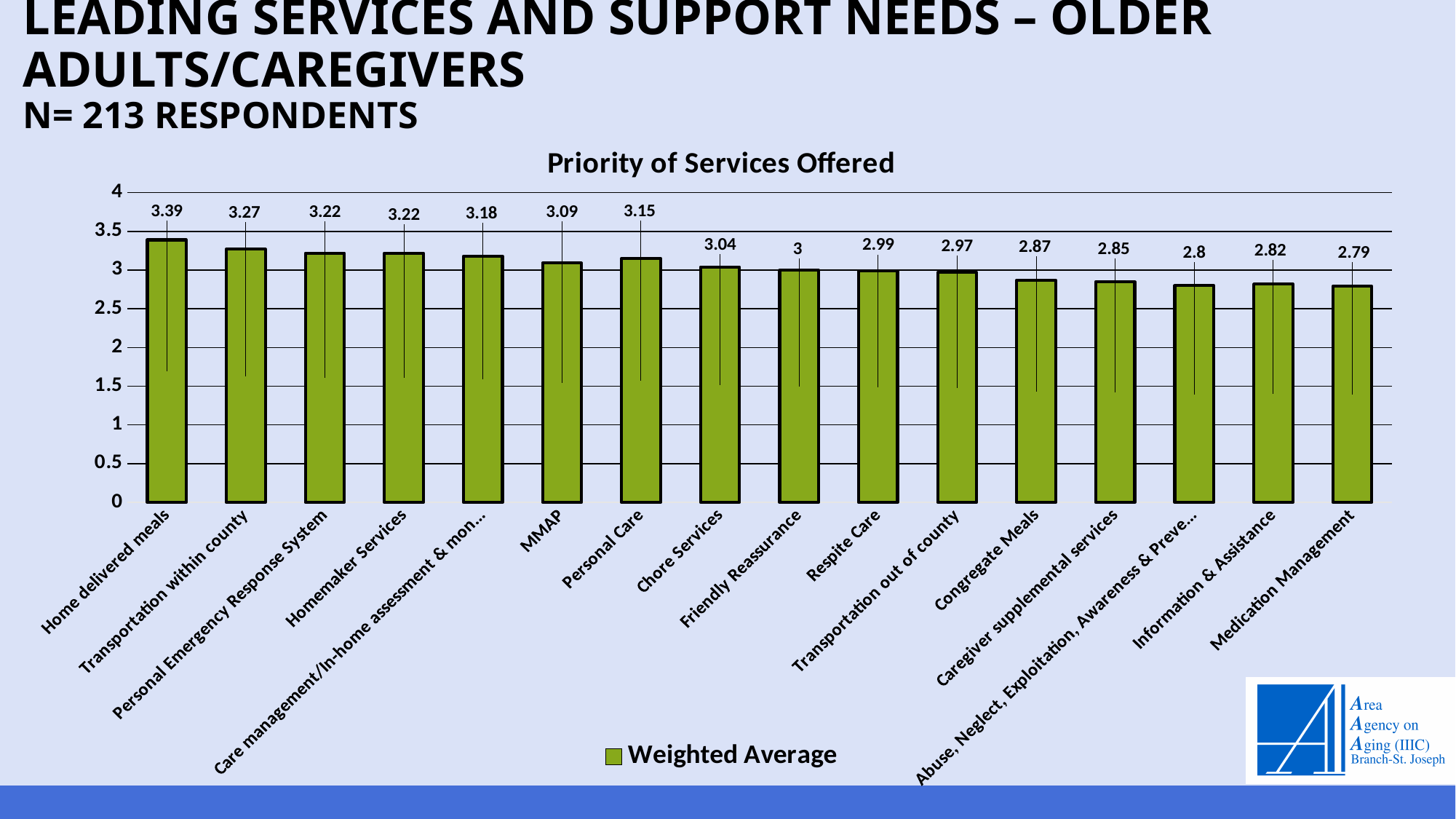
What is the weighted average for MMAP? 3.09 How many services are shown in the chart? 16 How many series does the legend list? 1 What is the weighted average for Medication Management? 2.79 What is the difference between the weighted averages for Home delivered meals and Transportation within county? 0.12 What type of chart is shown on the slide? Bar chart What is the weighted average for Chore Services? 3.04 What is the title of the chart? Priority of Services Offered Which service has the lowest weighted average? Medication Management Which service has the highest weighted average? Home delivered meals What is the weighted average for Home delivered meals? 3.39 Which has a higher weighted average, Personal Care or MMAP? Personal Care